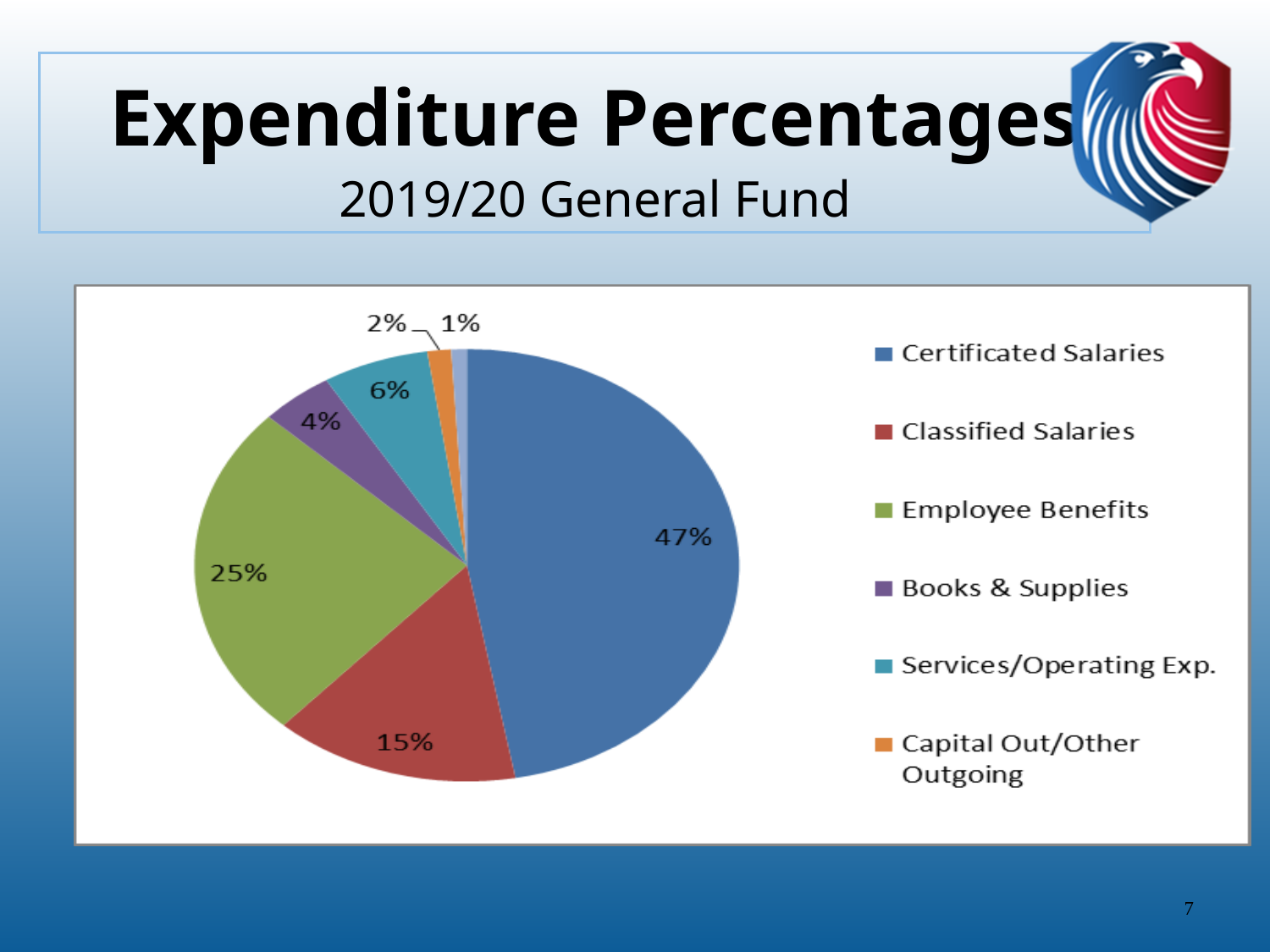
Which category has the largest share of the pie? Certificated Salaries How many categories are listed in the chart's legend? 6 What percentage is shown for Capital Out/Other Outgoing? 2% What percentage of the pie is Services/Operating Exp.? 6% What share of expenditures goes to Employee Benefits? 25% Which is larger, Classified Salaries or Employee Benefits? Employee Benefits What percentage is shown for Books & Supplies? 4% What is the difference in percentage points between Certificated Salaries and Classified Salaries? 32 What percentage of the pie chart is Certificated Salaries? 47% What kind of chart is shown on the slide? Pie chart What percentage is shown for Classified Salaries? 15% What is the combined percentage of Certificated Salaries and Classified Salaries? 62%